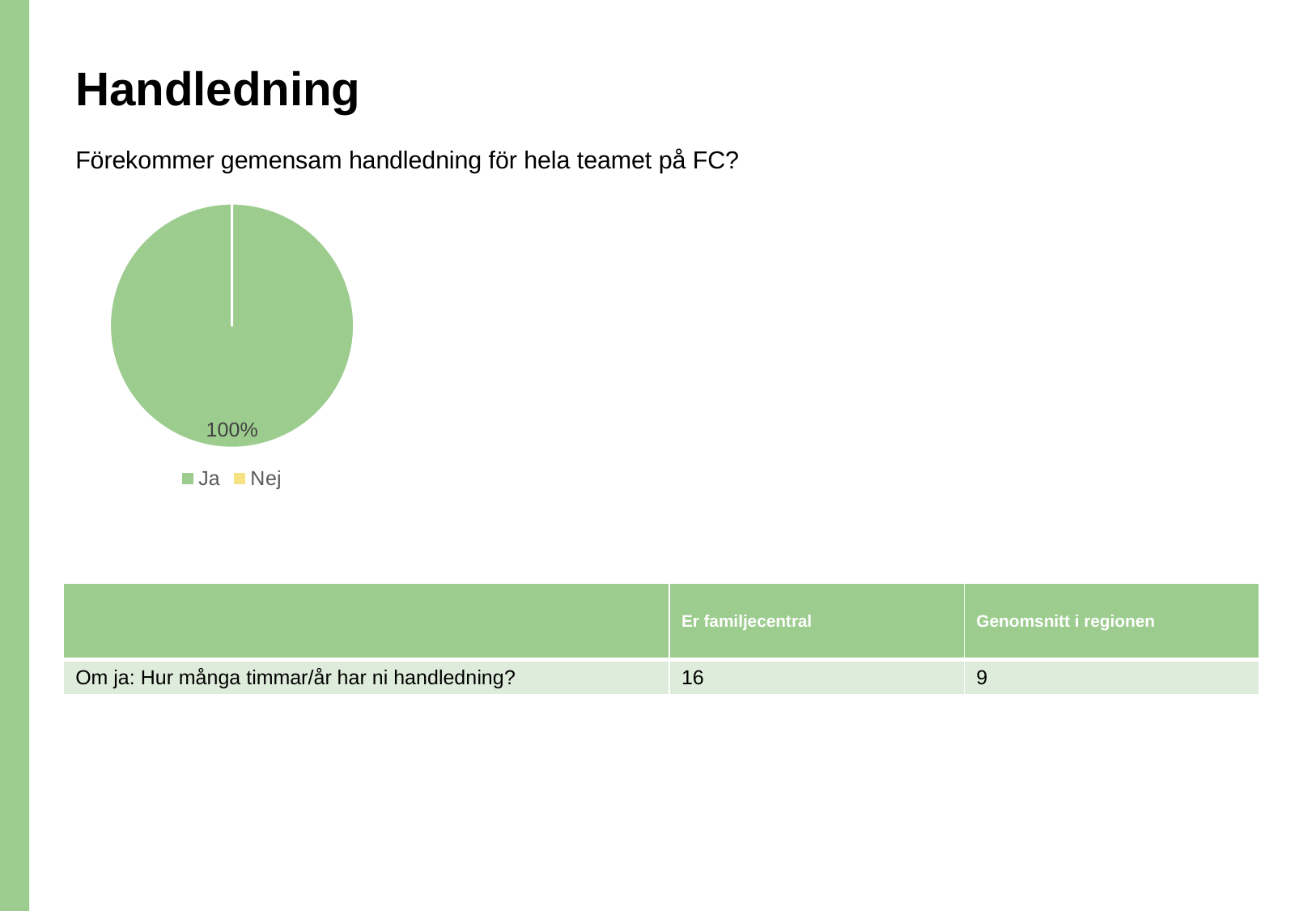
Which category has the smallest share in the pie chart? Nej Which category has the largest share in the pie chart? Ja What is the only percentage label printed on the pie chart? 100% What share of the pie chart does the Ja slice represent? 100% Which category has the larger share in the pie chart, Ja or Nej? Ja What kind of chart is shown on the slide? pie chart Is the share for Ja in the pie chart greater or less than 50%? greater What colour does the legend use for Nej? yellow How many categories does the legend of the pie chart list? 2 What colour is the Ja slice in the pie chart? green